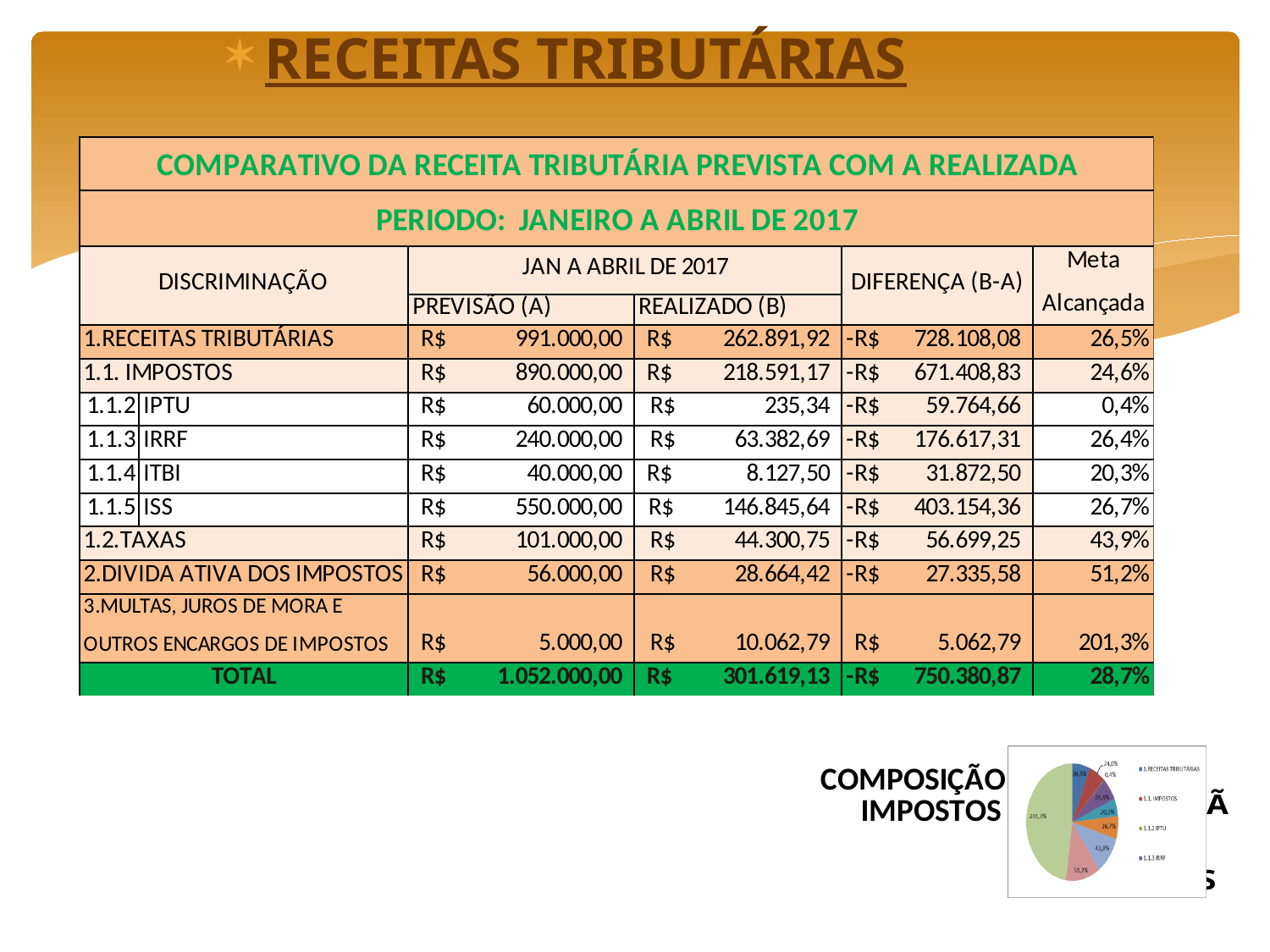
In the pie chart at the bottom right, which is larger: the slice labelled 201,3% or the slice labelled 51,2%? 201,3% What kind of chart is shown at the bottom right of the slide? pie chart In the pie chart at the bottom right, what is the value printed on the smallest slice? 0,4% In the pie chart at the bottom right, which is larger: the slice labelled 43,9% or the slice labelled 26,7%? 43,9% What heading is printed to the left of the pie chart at the bottom right of the slide? COMPOSIÇÃO IMPOSTOS In the pie chart at the bottom right, what is the value printed on the largest slice? 201,3% What is the first entry listed in the legend of the pie chart at the bottom right? 1.RECEITAS TRIBUTÁRIAS